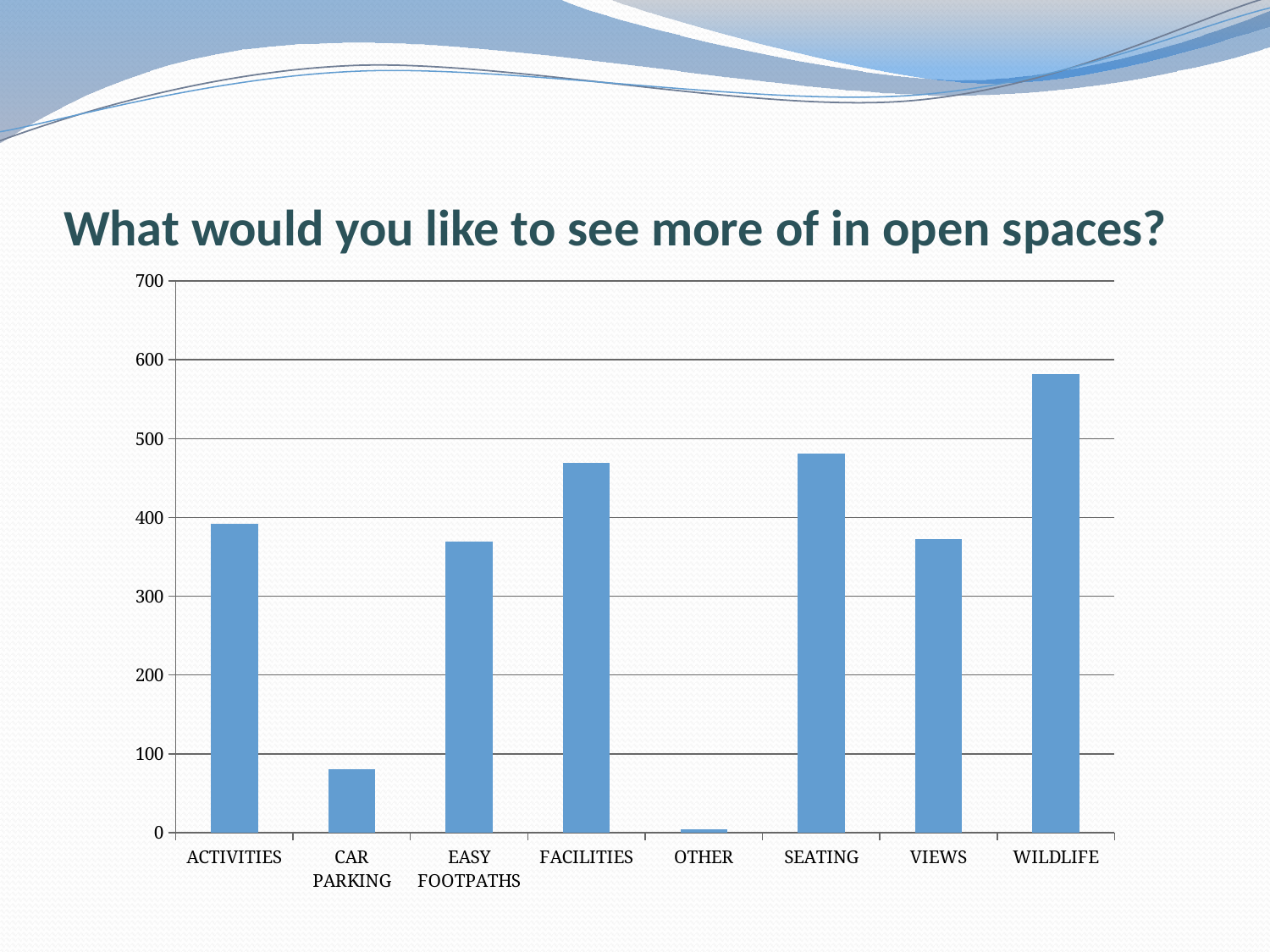
Which category has the lowest value? OTHER Is the value for WILDLIFE greater or less than 500? greater Is the value for EASY FOOTPATHS greater or less than 400? less What is the title of the chart? What would you like to see more of in open spaces? How many categories are shown on the x axis? 8 Is the value for SEATING greater or less than 500? less What kind of chart is shown on the slide? bar chart Which is larger, the value for FACILITIES or the value for ACTIVITIES? FACILITIES Which category has the highest value? WILDLIFE Which is larger, the value for WILDLIFE or the value for SEATING? WILDLIFE